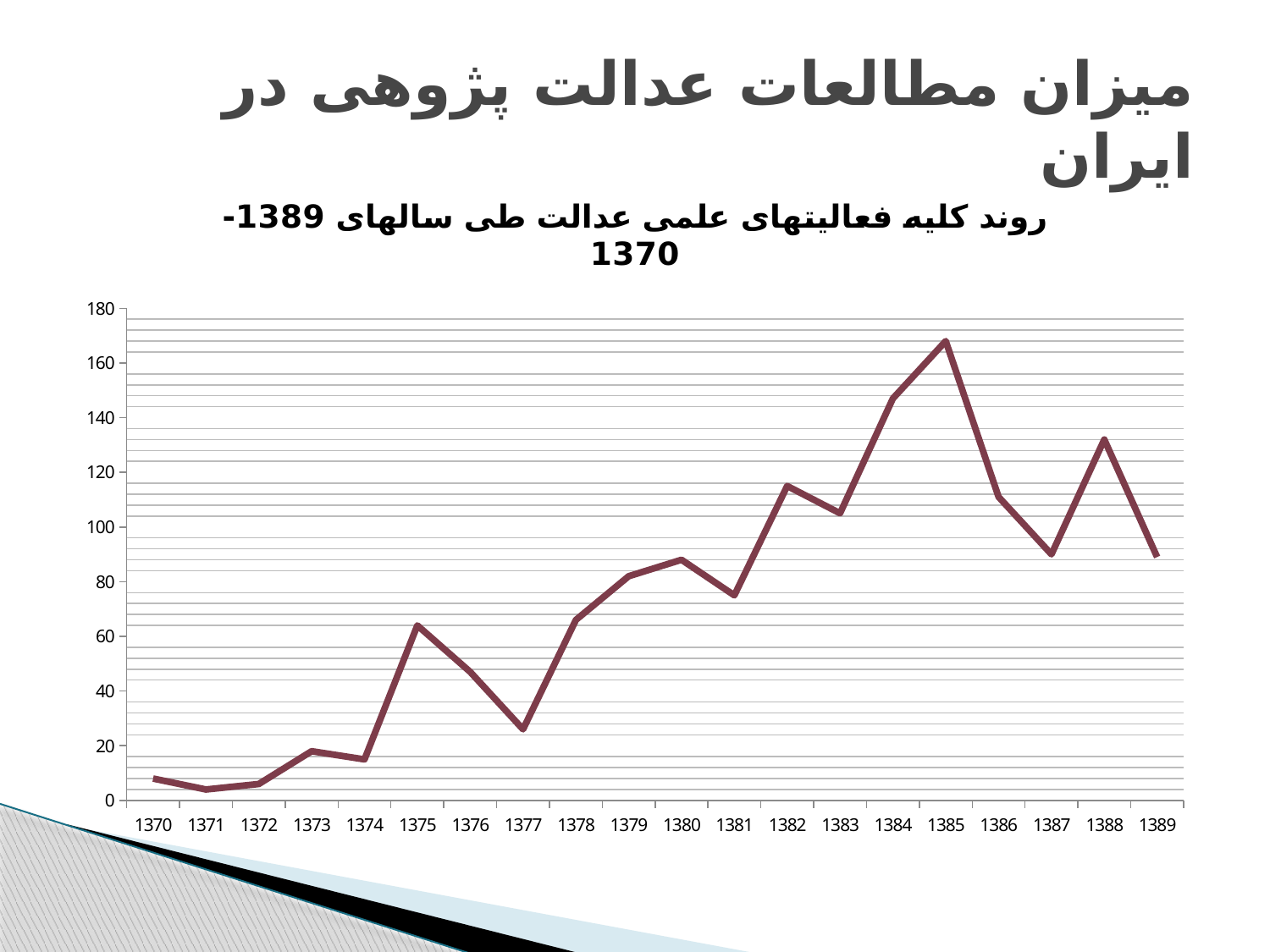
Is the value for 1380 greater or less than 100? less Do the values generally rise or fall from 1370 to 1385? rise Is the value for 1385 greater or less than 160? greater Which year has the larger value, 1385 or 1388? 1385 What kind of chart is shown on the slide? line chart Is the value for 1375 greater or less than 40? greater Which year has the larger value, 1375 or 1377? 1375 Which year has the highest value on the chart? 1385 How many years (data points) are plotted along the x axis? 20